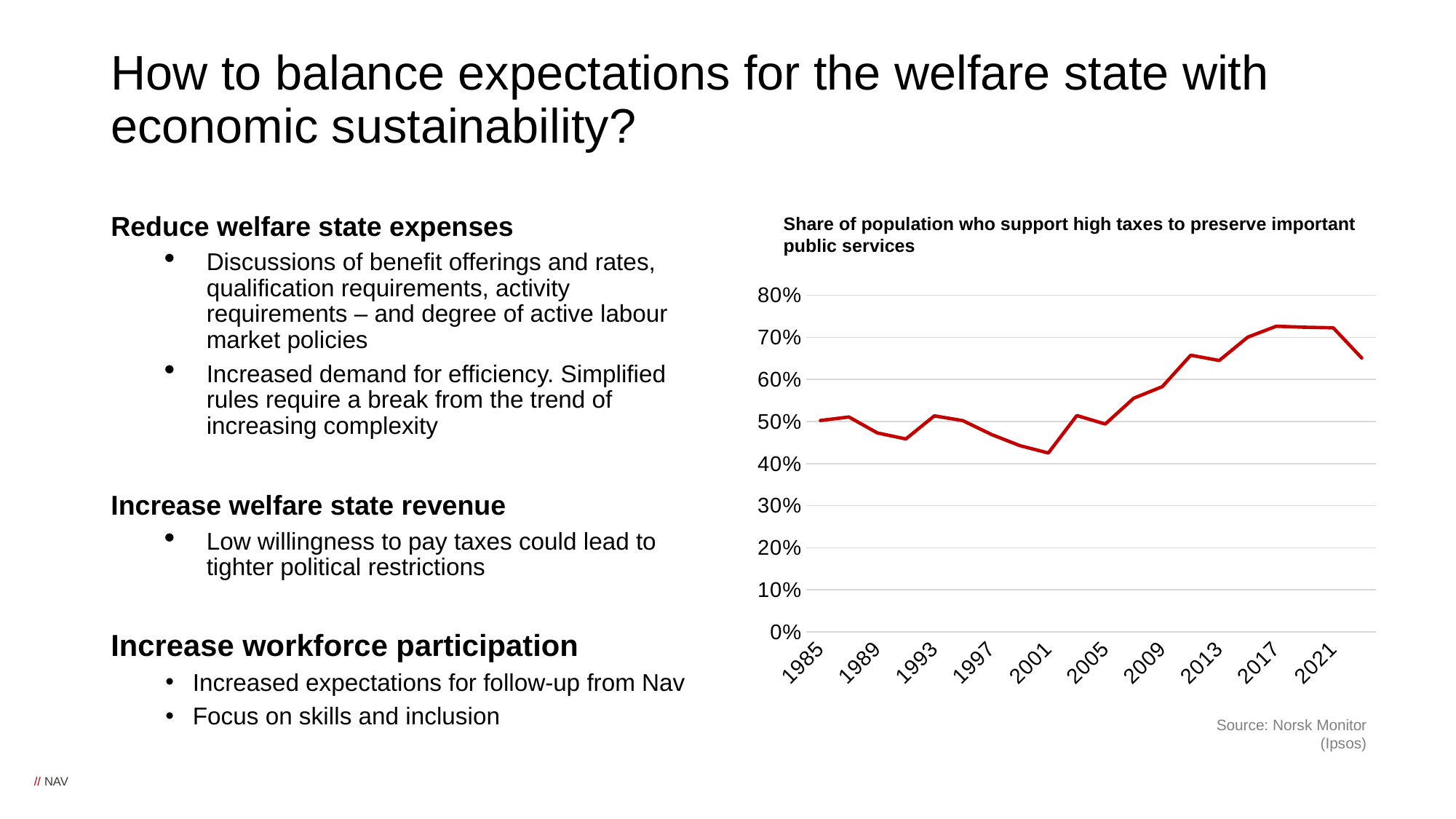
Is the value for 2017 greater or less than 70%? greater Which is larger, the value for 1985 or the value for 2013? 2013 Is the value for 2013 greater or less than 60%? greater What is the source cited for the chart? Norsk Monitor (Ipsos) Is the value for 2001 greater or less than 50%? less Which labelled year on the x axis has the lowest value? 2001 Which is larger, the value for 2001 or the value for 2017? 2017 What kind of chart is shown on the slide? line chart What is the title of the chart? Share of population who support high taxes to preserve important public services Overall, do the values rise or fall from 1985 to 2021? rise